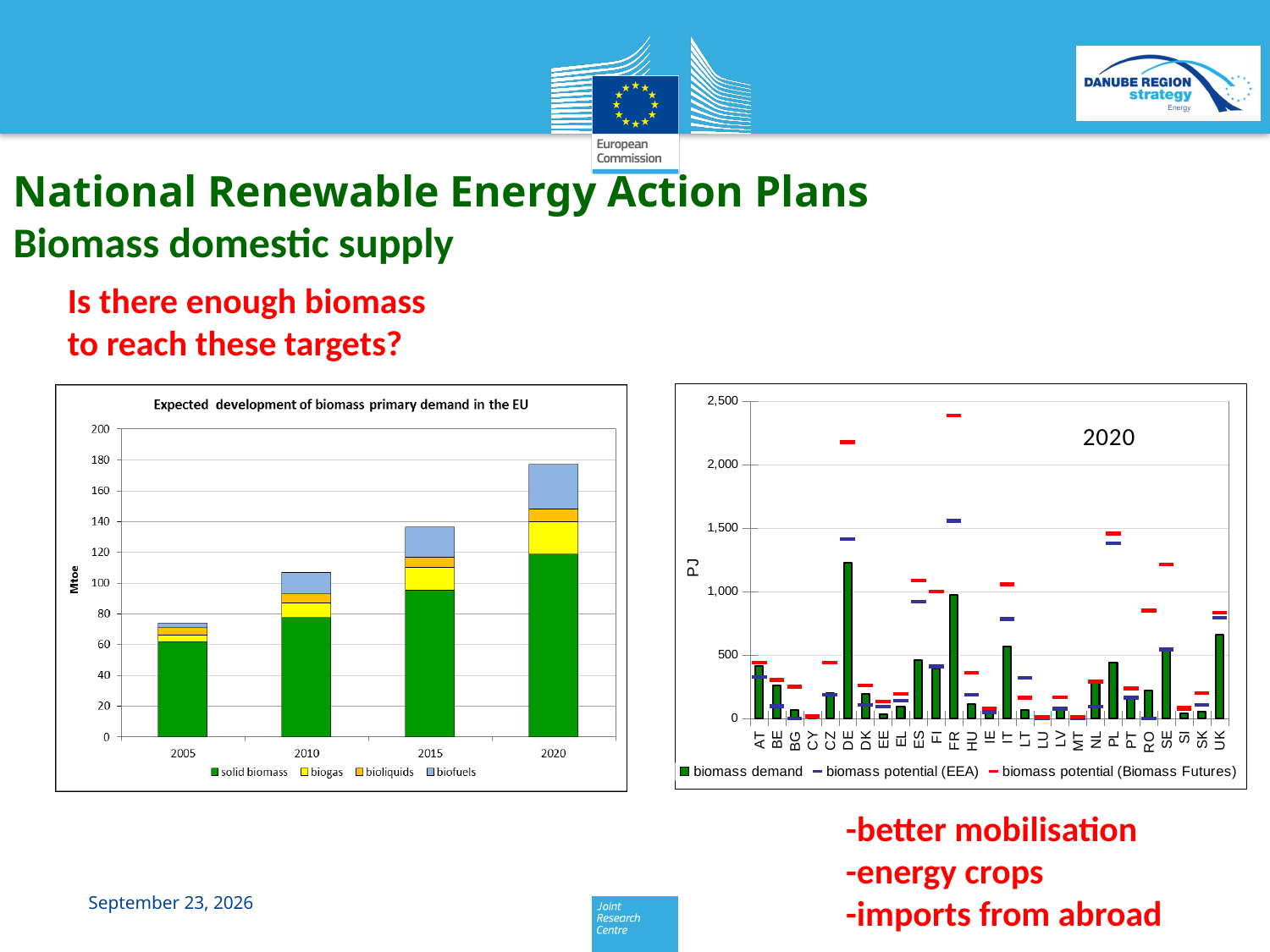
In the left chart, 'Expected development of biomass primary demand in the EU', which year has the highest total biomass demand? 2020 In the left chart, 'Expected development of biomass primary demand in the EU', is the total for 2005 greater or less than 80 Mtoe? less In the left chart, 'Expected development of biomass primary demand in the EU', how many series does the legend list? 4 In the left chart, 'Expected development of biomass primary demand in the EU', how many years are shown on the x axis? 4 In the left chart, 'Expected development of biomass primary demand in the EU', what is the unit shown on the y axis? Mtoe In the right chart (2020, PJ), how many series does the legend list? 3 In the right chart (2020, PJ), is the biomass demand for DE greater or less than 1,000 PJ? greater What kind of chart is the left chart, 'Expected development of biomass primary demand in the EU'? stacked bar chart In the left chart, 'Expected development of biomass primary demand in the EU', is the total for 2020 greater or less than 160 Mtoe? greater In the right chart (2020, PJ), which has the larger biomass demand, DE or FR? DE In the left chart, 'Expected development of biomass primary demand in the EU', do the total bar heights rise or fall from 2005 to 2020? rise In the right chart (2020, PJ), which country has the highest biomass demand? DE